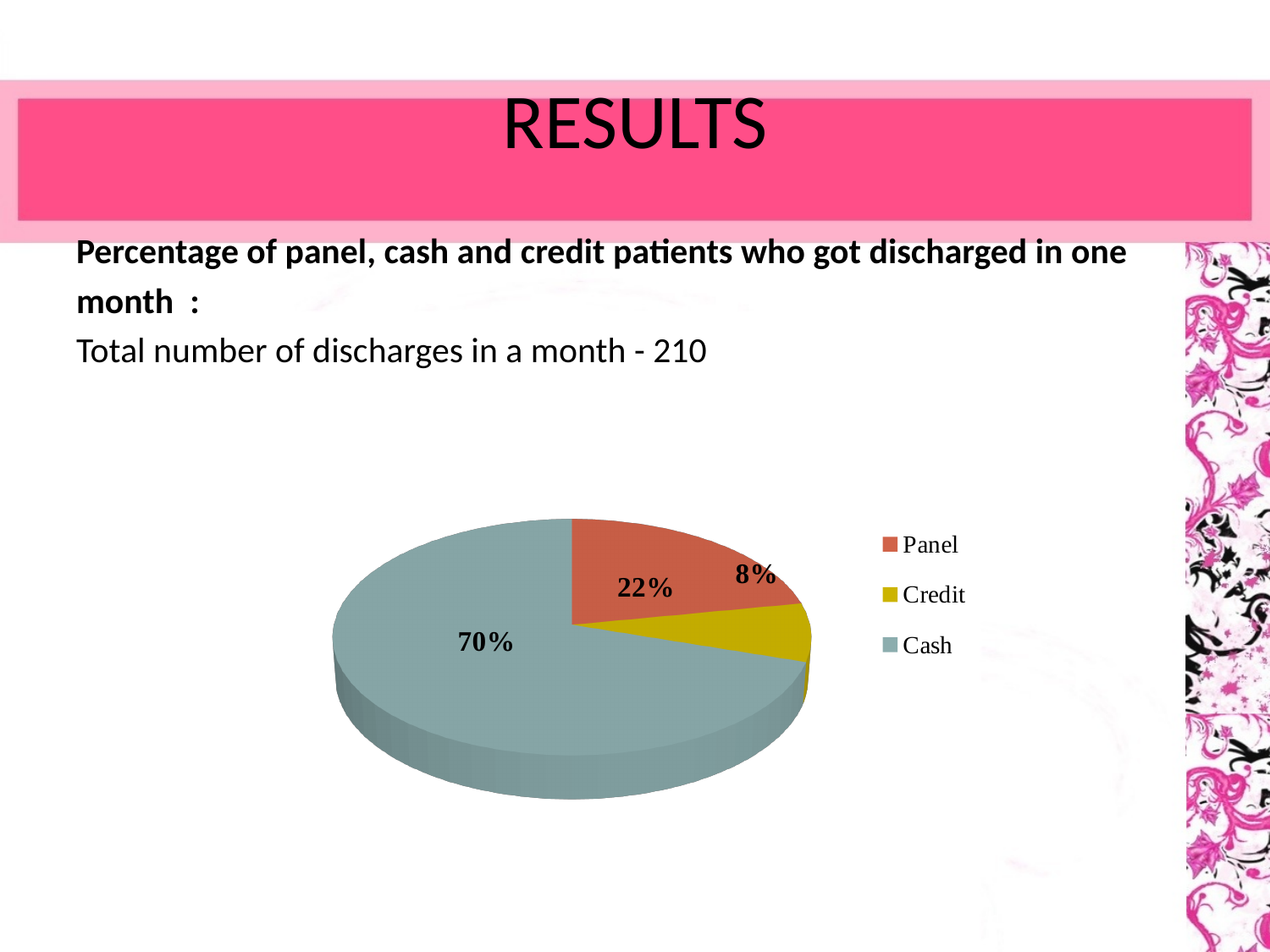
What is the difference in percentage points between the Panel and Credit slices? 14 What percentage of discharged patients were Credit patients? 8% Which category has the largest share of the pie? Cash How many entries does the legend list? 3 What colour is the Cash slice in the pie chart? Grey-blue What type of chart is shown on the slide? Pie chart What is the difference in percentage points between the Cash and Panel slices? 48 Which slice is larger, Panel or Credit? Panel What percentage of discharged patients were Cash patients? 70% Which category has the smallest share of the pie? Credit How many categories are shown in the pie chart? 3 What percentage of discharged patients were Panel patients? 22%